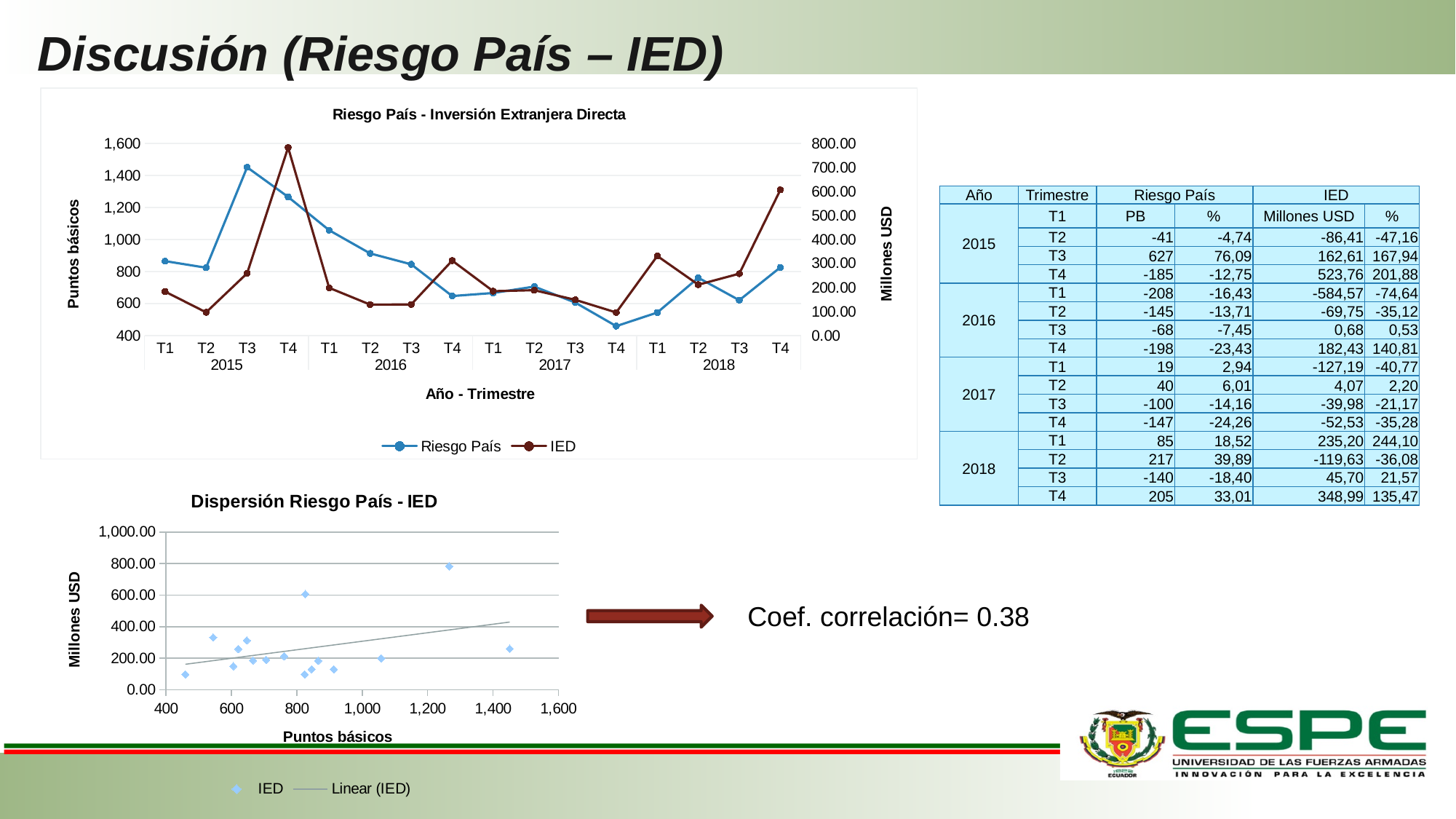
In the top chart 'Riesgo País - Inversión Extranjera Directa', how many quarters are plotted along the x axis? 16 What kind of chart is the top chart titled 'Riesgo País - Inversión Extranjera Directa'? line chart In the bottom chart 'Dispersión Riesgo País - IED', what are the two entries listed in the legend? IED and Linear (IED) In the top chart 'Riesgo País - Inversión Extranjera Directa', is the IED value for T4 2015 greater or less than 700.00? greater In the top chart 'Riesgo País - Inversión Extranjera Directa', in which quarter does the Riesgo País series reach its highest value? T3 2015 What kind of chart is the bottom chart titled 'Dispersión Riesgo País - IED'? scatter chart In the top chart 'Riesgo País - Inversión Extranjera Directa', does the Riesgo País series rise or fall from T3 2015 to T4 2017? fall In the top chart 'Riesgo País - Inversión Extranjera Directa', how many series does the legend list? 2 In the top chart 'Riesgo País - Inversión Extranjera Directa', in which quarter does the IED series reach its highest value? T4 2015 In the top chart 'Riesgo País - Inversión Extranjera Directa', is the Riesgo País value for T4 2017 greater or less than 600? less In the top chart 'Riesgo País - Inversión Extranjera Directa', is the Riesgo País value for T3 2015 greater or less than 1,200? greater In the top chart 'Riesgo País - Inversión Extranjera Directa', in which quarter is the Riesgo País series at its lowest? T4 2017